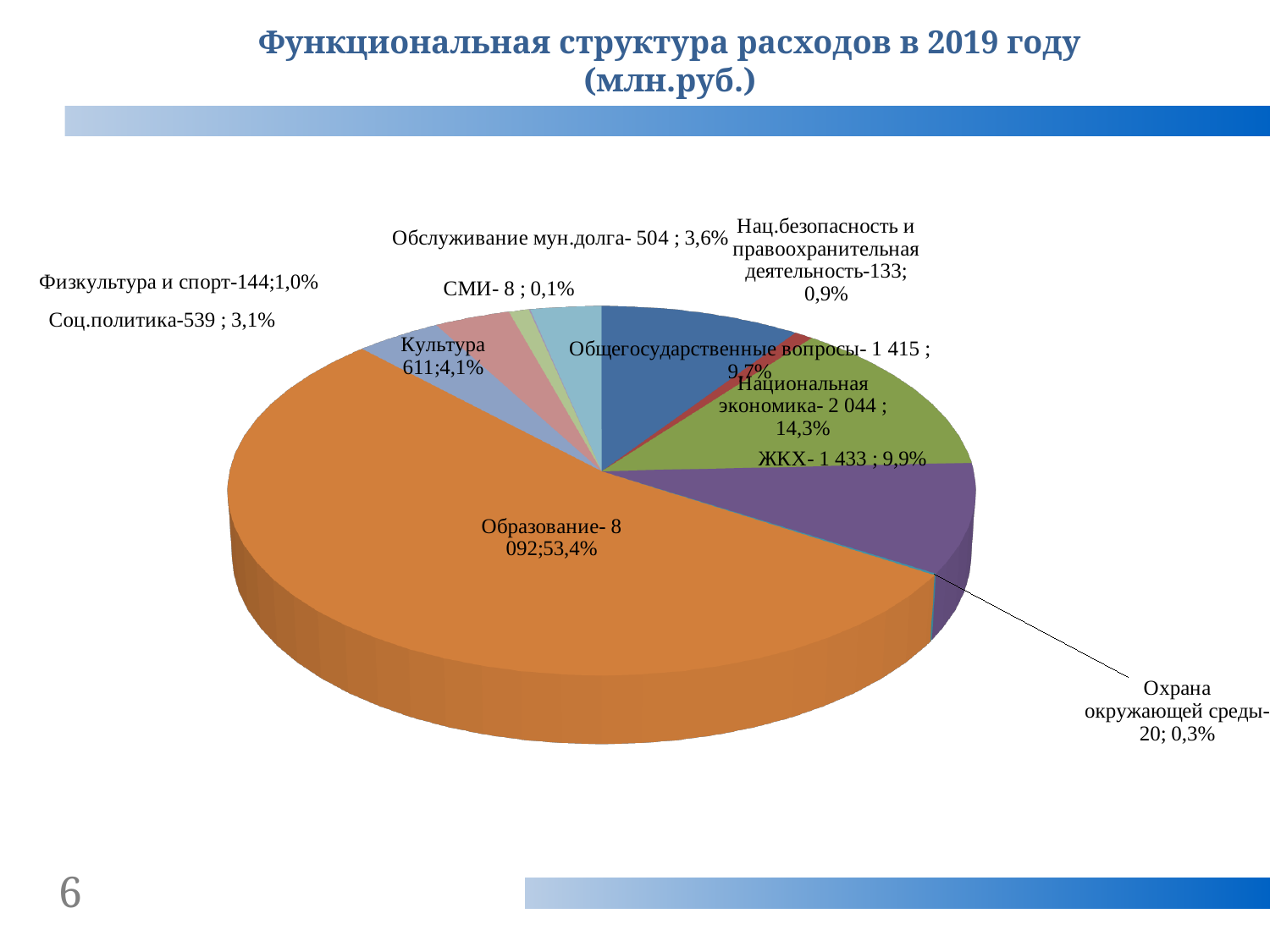
What share of the pie does Образование account for? 53,4% What kind of chart is shown on the slide? Pie chart What is the title of the chart? Функциональная структура расходов в 2019 году (млн.руб.) What is the value for Образование in the pie chart? 8 092 What is the value for Охрана окружающей среды? 20 What is the difference between the values for Национальная экономика and Общегосударственные вопросы? 629 Which category has the smallest slice of the pie? СМИ How many categories are shown in the pie chart? 11 Which is larger, the value for Культура or the value for Соц.политика? Культура What is the value for Национальная экономика? 2 044 Which category has the largest slice of the pie? Образование What share of the pie does ЖКХ account for? 9,9%